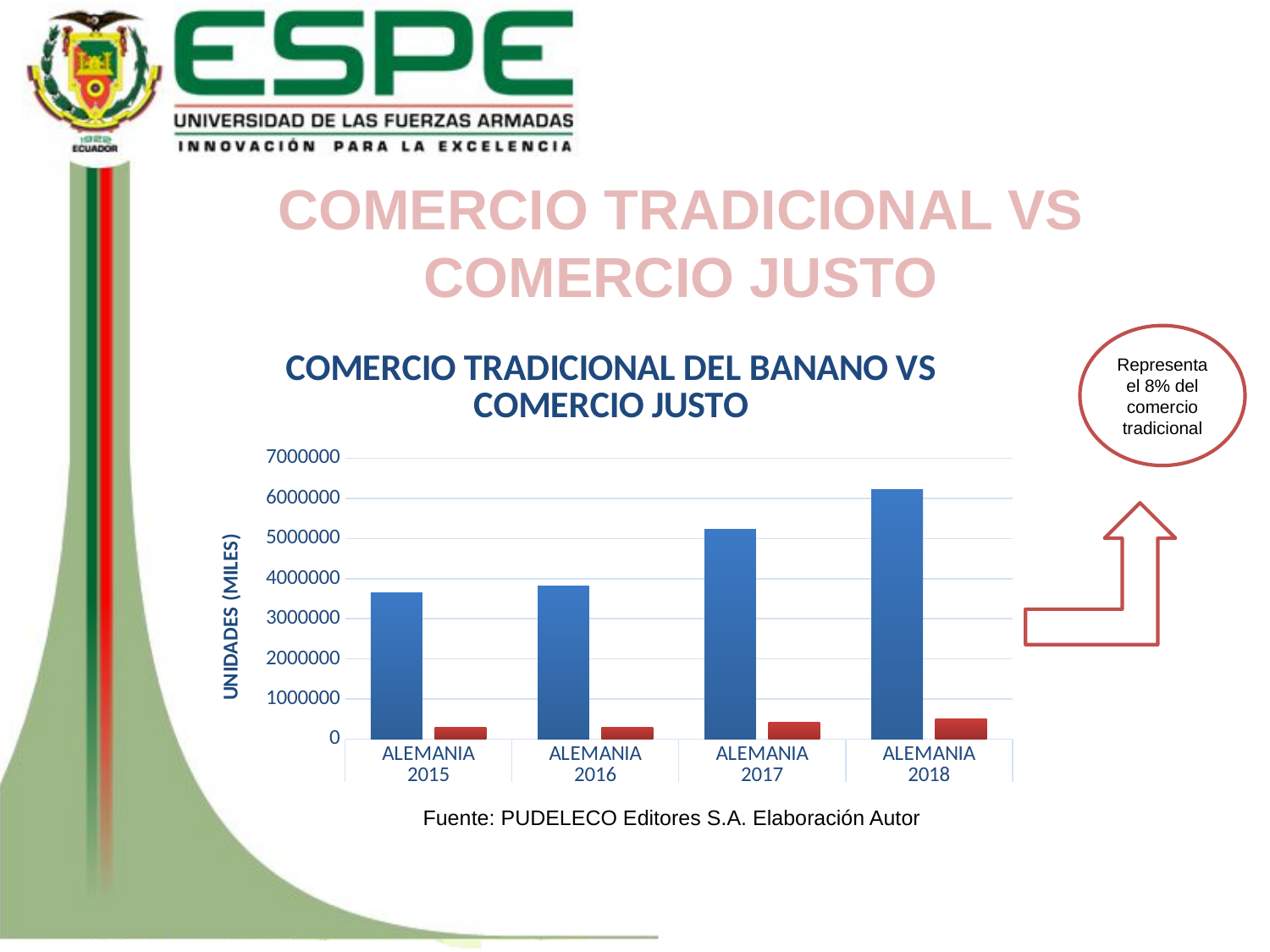
Do the blue bars rise or fall from ALEMANIA 2015 to ALEMANIA 2018? rise Is the blue bar for ALEMANIA 2017 greater or less than 5000000? greater Which category has the shortest blue bar? ALEMANIA 2015 Which category has the tallest blue bar? ALEMANIA 2018 Is the red bar for ALEMANIA 2018 greater or less than 1000000? less What is the label on the vertical axis of the chart? UNIDADES (MILES) How many categories are shown on the x axis of the chart? 4 Which is larger, the blue bar for ALEMANIA 2017 or the blue bar for ALEMANIA 2016? ALEMANIA 2017 What kind of chart is shown on the slide? bar chart Is the blue bar for ALEMANIA 2018 greater or less than 6000000? greater How many bars are plotted for each category in the chart? 2